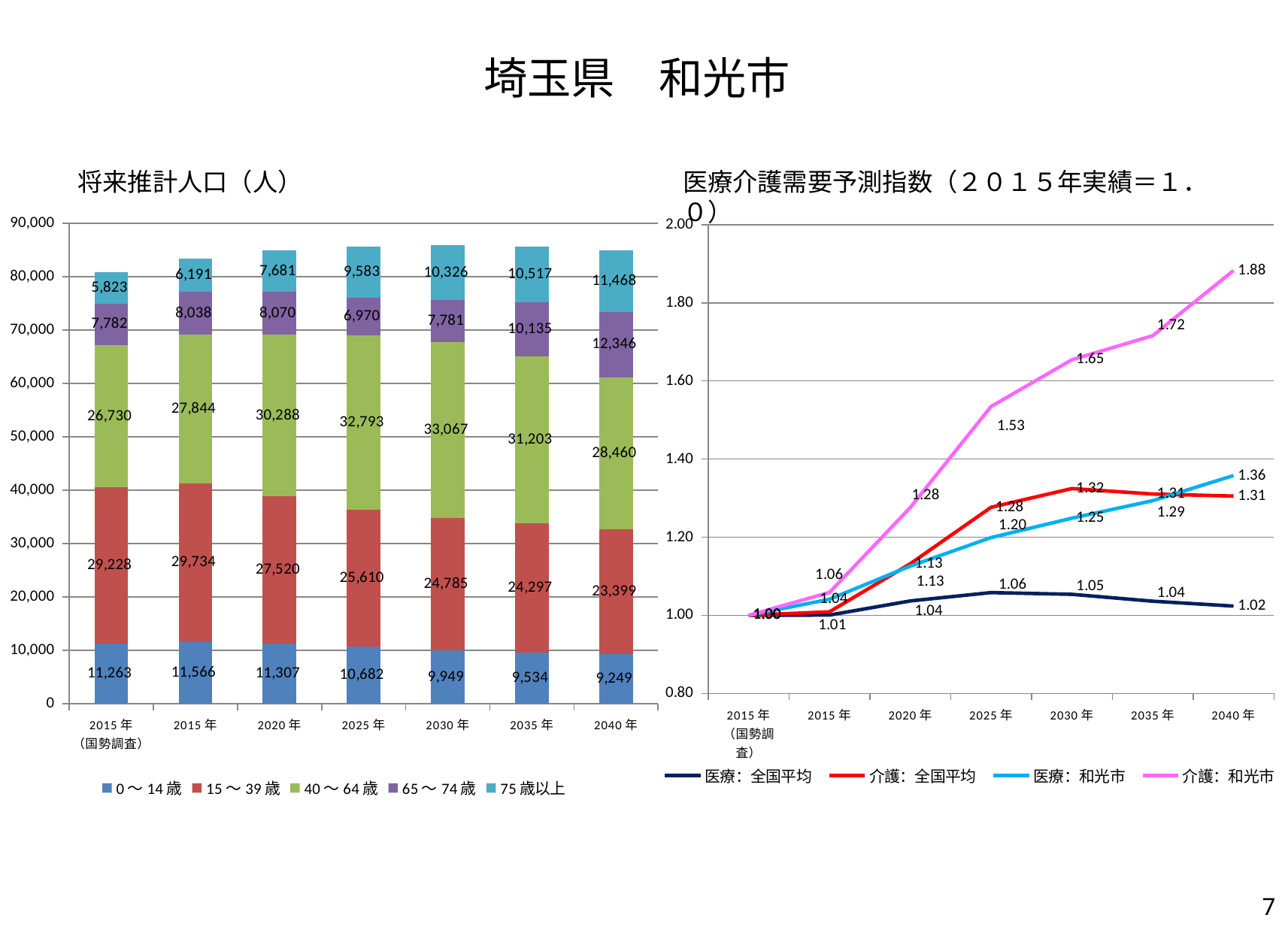
In the right chart 医療介護需要予測指数, which is larger in 2040年: 介護：和光市 or 介護：全国平均? 介護：和光市 In the left chart 将来推計人口（人）, what is the difference between the 0～14歳 values for 2015年 and 2040年? 2,317 In the left chart 将来推計人口（人）, in which year is the 40～64歳 segment the largest? 2030年 What kind of chart is the right chart titled 医療介護需要予測指数? Line chart In the left chart 将来推計人口（人）, how many series does the legend list? 5 In the right chart 医療介護需要予測指数, does the 介護：和光市 line rise or fall from 2015年 to 2040年? Rise What kind of chart is the left chart titled 将来推計人口（人）? Stacked bar chart In the right chart 医療介護需要予測指数, what is the value for 介護：和光市 in 2040年? 1.88 In the left chart 将来推計人口（人）, what is the total of the stacked bar for 2040年? 84,922 In the left chart 将来推計人口（人）, what is the value for 75歳以上 in 2040年? 11,468 In the right chart 医療介護需要予測指数, how many series does the legend list? 4 In the left chart 将来推計人口（人）, what is the value for 40～64歳 in 2030年? 33,067